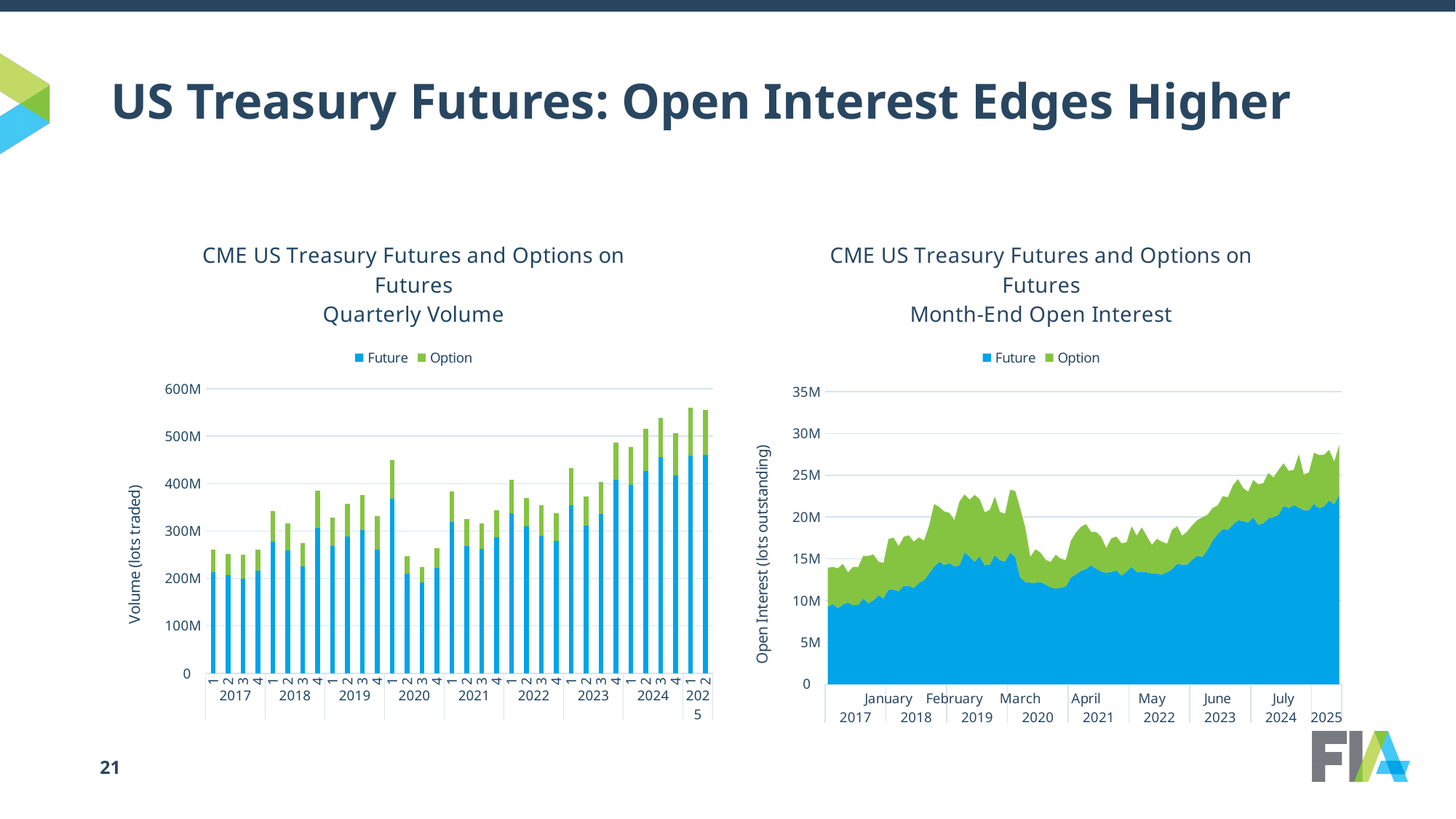
In the 'Quarterly Volume' chart, is the total volume for quarter 1 of 2025 greater or less than 500M? greater In the 'Month-End Open Interest' chart, is the total open interest at the end of the series in 2025 greater or less than 25M? greater What kind of chart is the 'Quarterly Volume' chart on the left? Stacked bar chart In the 'Quarterly Volume' chart, is the total volume for quarter 1 of 2020 greater or less than 400M? greater In the 'Month-End Open Interest' chart, does total open interest generally rise or fall from 2017 to 2025? Rise In the 'Month-End Open Interest' chart, which series is shown in green? Option What kind of chart is the 'Month-End Open Interest' chart on the right? Stacked area chart In the 'Quarterly Volume' chart, which quarter has the lowest total volume? Quarter 3 of 2020 How many series does the legend of the 'Quarterly Volume' chart list? 2